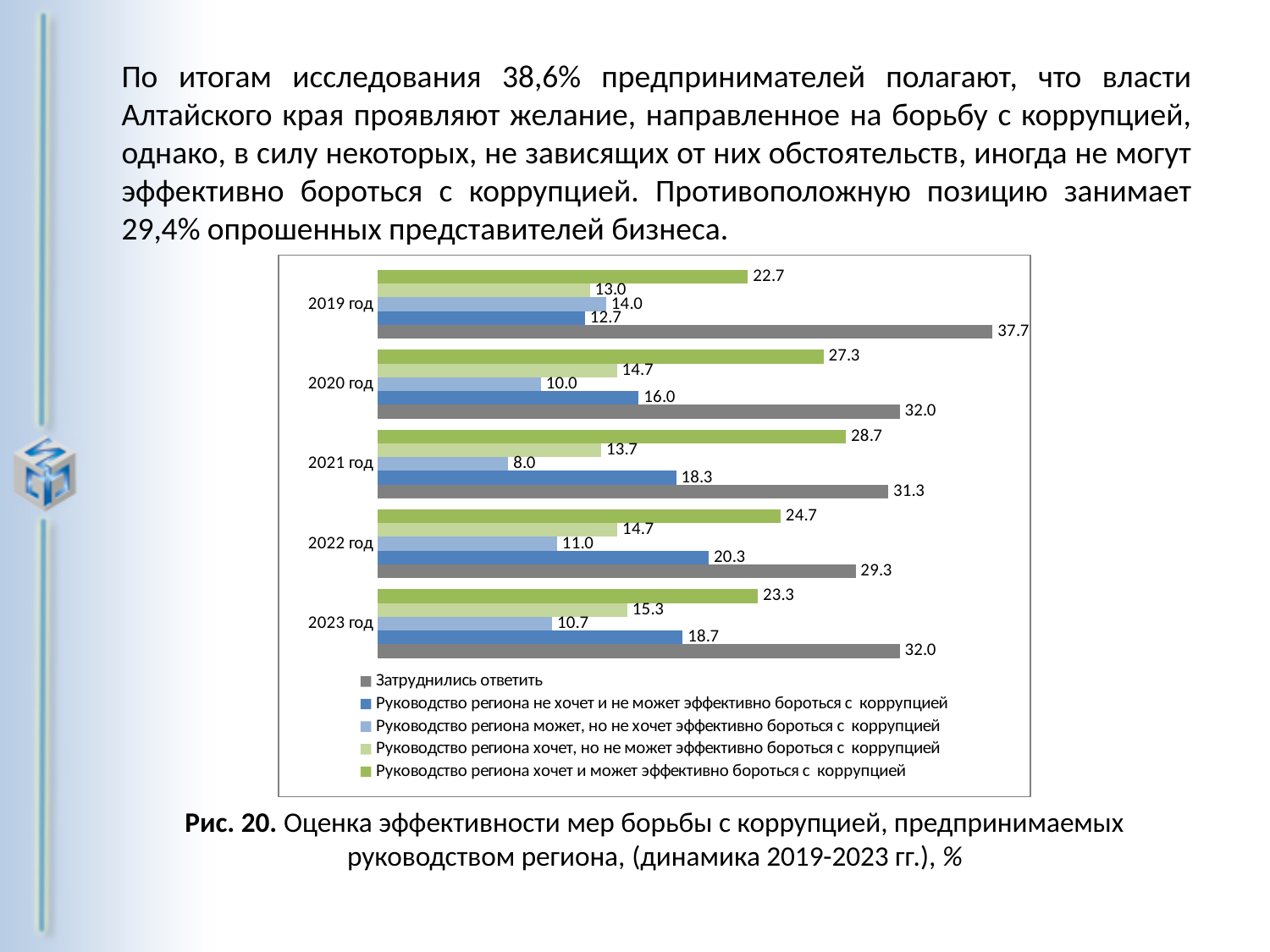
How many series does the legend list? 5 What is the value for "Затруднились ответить" in 2019 год? 37.7 What is the value for "Руководство региона не хочет и не может эффективно бороться с коррупцией" in 2022 год? 20.3 How many year categories are shown on the chart? 5 Does the value for "Руководство региона не хочет и не может эффективно бороться с коррупцией" rise or fall from 2019 год to 2022 год? rise Which is larger in 2020 год: "Руководство региона хочет и может эффективно бороться с коррупцией" or "Руководство региона не хочет и не может эффективно бороться с коррупцией"? Руководство региона хочет и может эффективно бороться с коррупцией What kind of chart is shown on the slide? bar chart What is the value for "Руководство региона хочет и может эффективно бороться с коррупцией" in 2021 год? 28.7 What is the value for "Руководство региона может, но не хочет эффективно бороться с коррупцией" in 2023 год? 10.7 In which year is the value for "Руководство региона может, но не хочет эффективно бороться с коррупцией" lowest? 2021 год In which year is the value for "Затруднились ответить" highest? 2019 год What is the difference between the "Затруднились ответить" values for 2019 год and 2022 год? 8.4